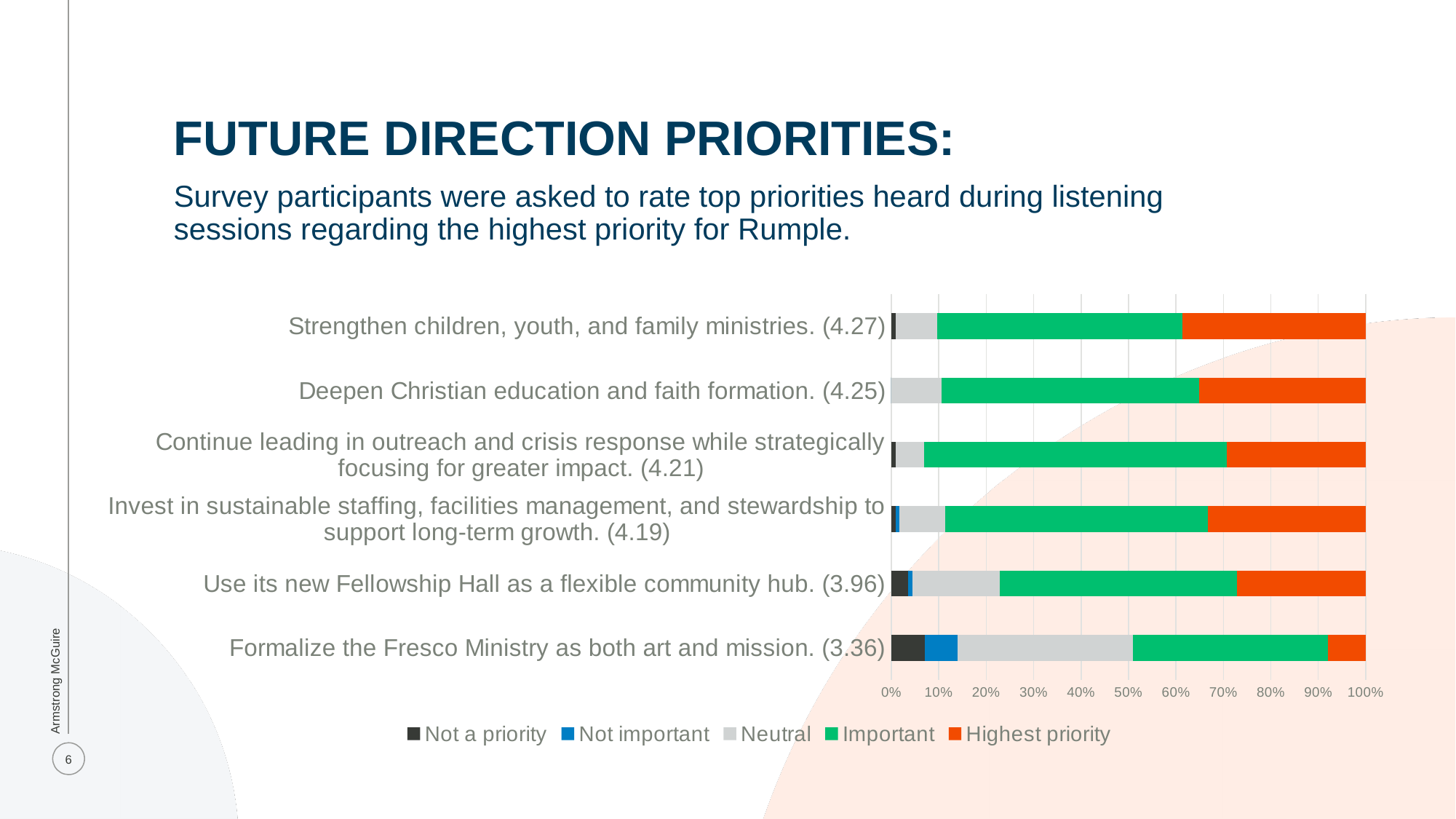
Which has a larger "Highest priority" share: "Strengthen children, youth, and family ministries" or "Formalize the Fresco Ministry as both art and mission"? Strengthen children, youth, and family ministries Is the "Highest priority" share for "Strengthen children, youth, and family ministries" greater or less than 30%? greater Which priority has the largest "Neutral" share? Formalize the Fresco Ministry as both art and mission. (3.36) How many series does the chart legend list? 5 What average rating is shown in the label for "Use its new Fellowship Hall as a flexible community hub"? 3.96 How many priority categories are plotted in the chart? 6 What type of chart is shown on the slide? Stacked bar chart Which priority has the lowest average rating shown in its label? Formalize the Fresco Ministry as both art and mission. (3.36) What is the difference between the average rating for "Strengthen children, youth, and family ministries" (4.27) and "Formalize the Fresco Ministry as both art and mission" (3.36)? 0.91 Is the "Highest priority" share for "Formalize the Fresco Ministry as both art and mission" greater or less than 10%? less Which priority has the highest average rating shown in its label? Strengthen children, youth, and family ministries. (4.27) Which colour represents "Highest priority" in the chart legend? Orange